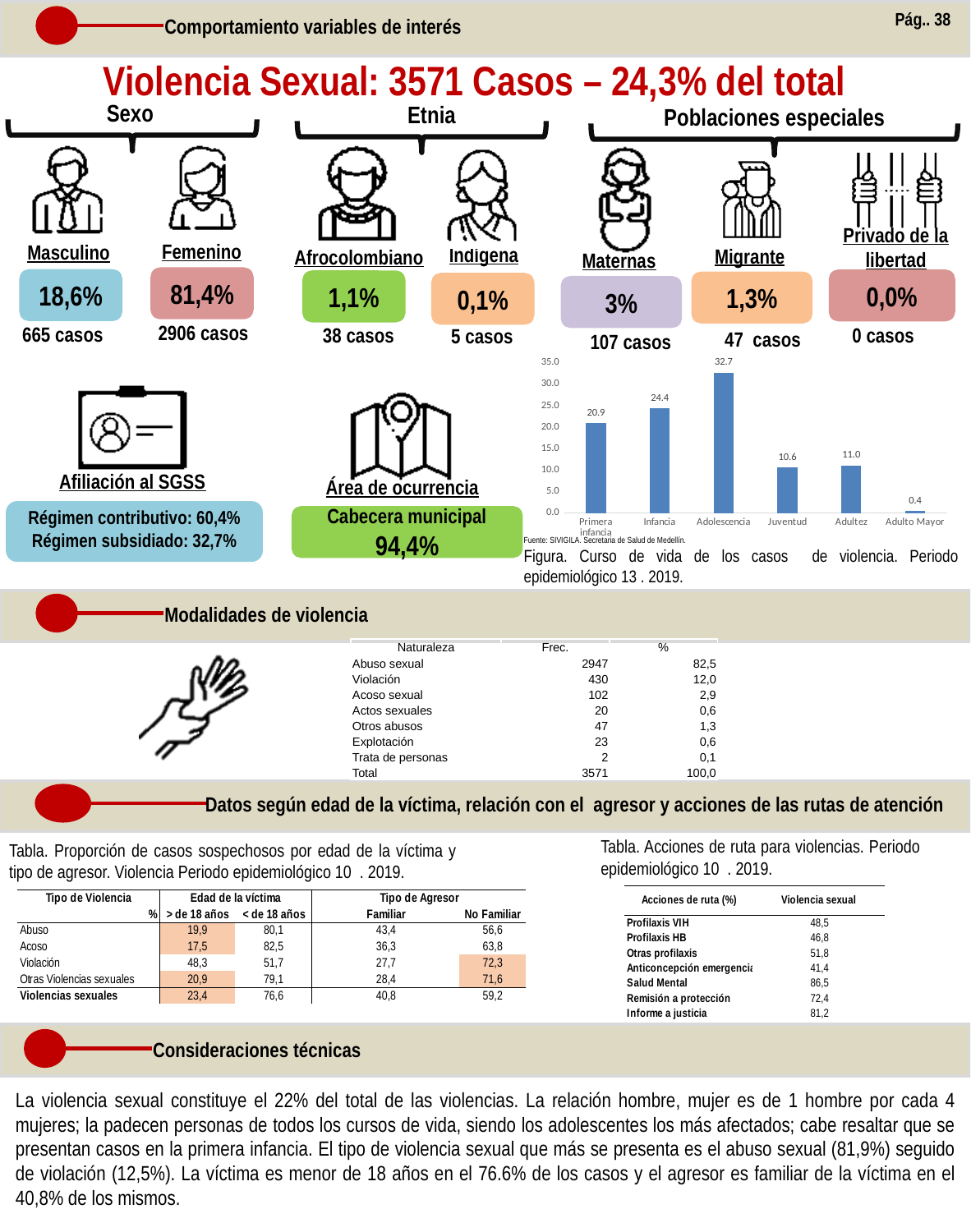
In the bar chart of cases by life course, what is the difference between the values for Adultez and Juventud? 0.4 In the bar chart of cases by life course, what is the value for Adolescencia? 32.7 In the bar chart of cases by life course, what is the difference between the values for Adolescencia and Infancia? 8.3 In the bar chart of cases by life course, what is the value for Primera infancia? 20.9 In the bar chart of cases by life course, is the value for Adolescencia greater or less than 30.0? greater In the bar chart of cases by life course, which category has the highest value? Adolescencia How many categories are shown on the x axis of the bar chart of cases by life course? 6 In the bar chart of cases by life course, which is larger: the value for Infancia or the value for Adultez? Infancia In the bar chart of cases by life course, what is the value for Juventud? 10.6 In the bar chart of cases by life course, what is the value for Adulto Mayor? 0.4 What type of chart is used to show the cases by life course (curso de vida)? bar chart In the bar chart of cases by life course, which category has the lowest value? Adulto Mayor